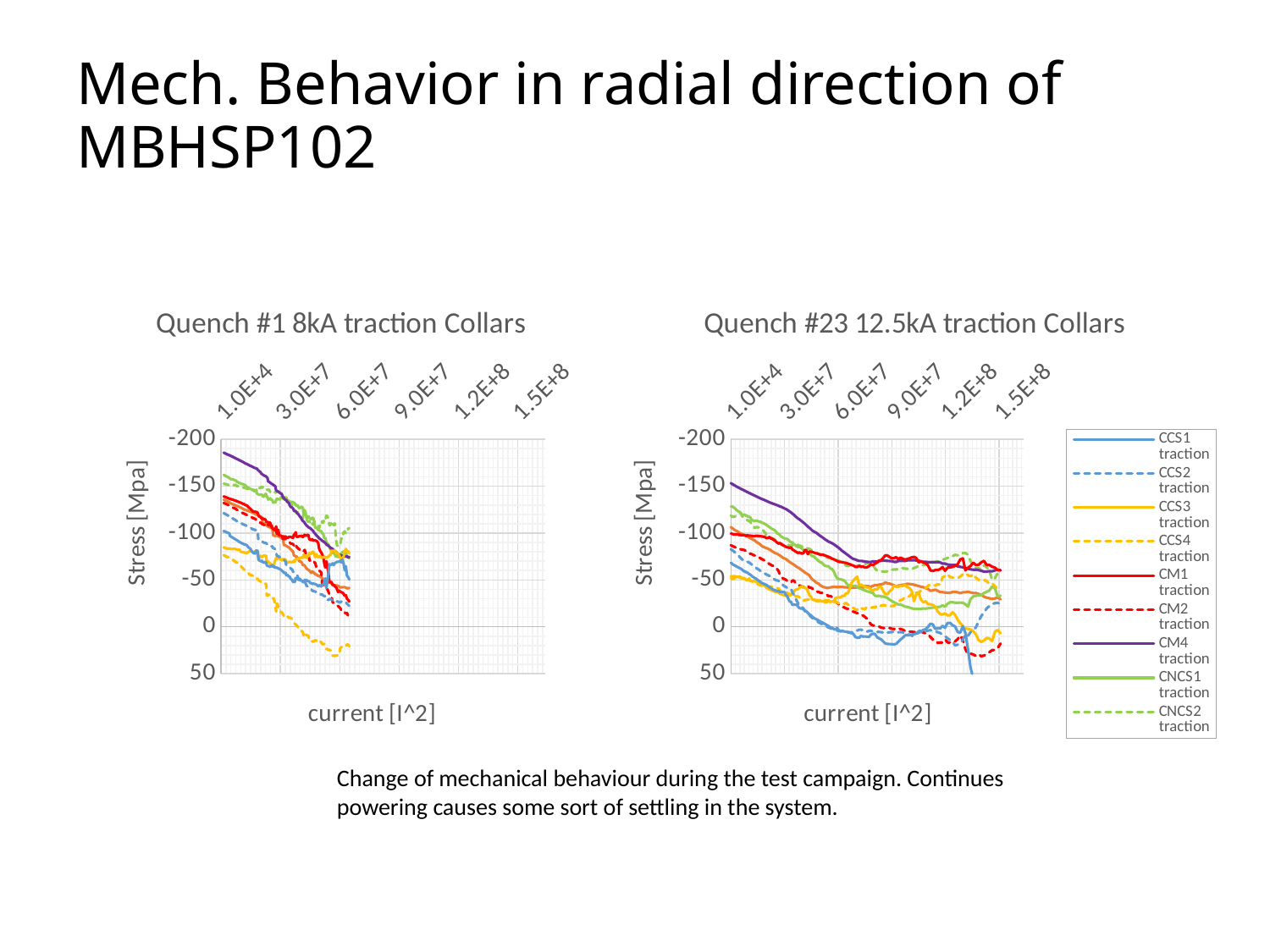
How many series does the legend list? 9 In the right chart, is the starting value of CNCS1 traction greater or less than -100? less How many tick labels are shown on the x axis of the right chart? 6 In the left chart, which series has the most negative stress value at the start of the x axis? CM4 traction What is the y-axis label on the left chart? Stress [Mpa] In the right chart, which series has the most negative stress value at the start of the x axis? CM4 traction What kind of chart is the left chart, 'Quench #1 8kA traction Collars'? line chart In the left chart, is the starting value of CM4 traction greater or less than -150? less What is the title of the right chart? Quench #23 12.5kA traction Collars In the left chart, does the CM4 traction value become less negative (move toward 0) or more negative as current increases along the x axis? less negative In the right chart, is the final value of CCS1 traction greater or less than 0? greater